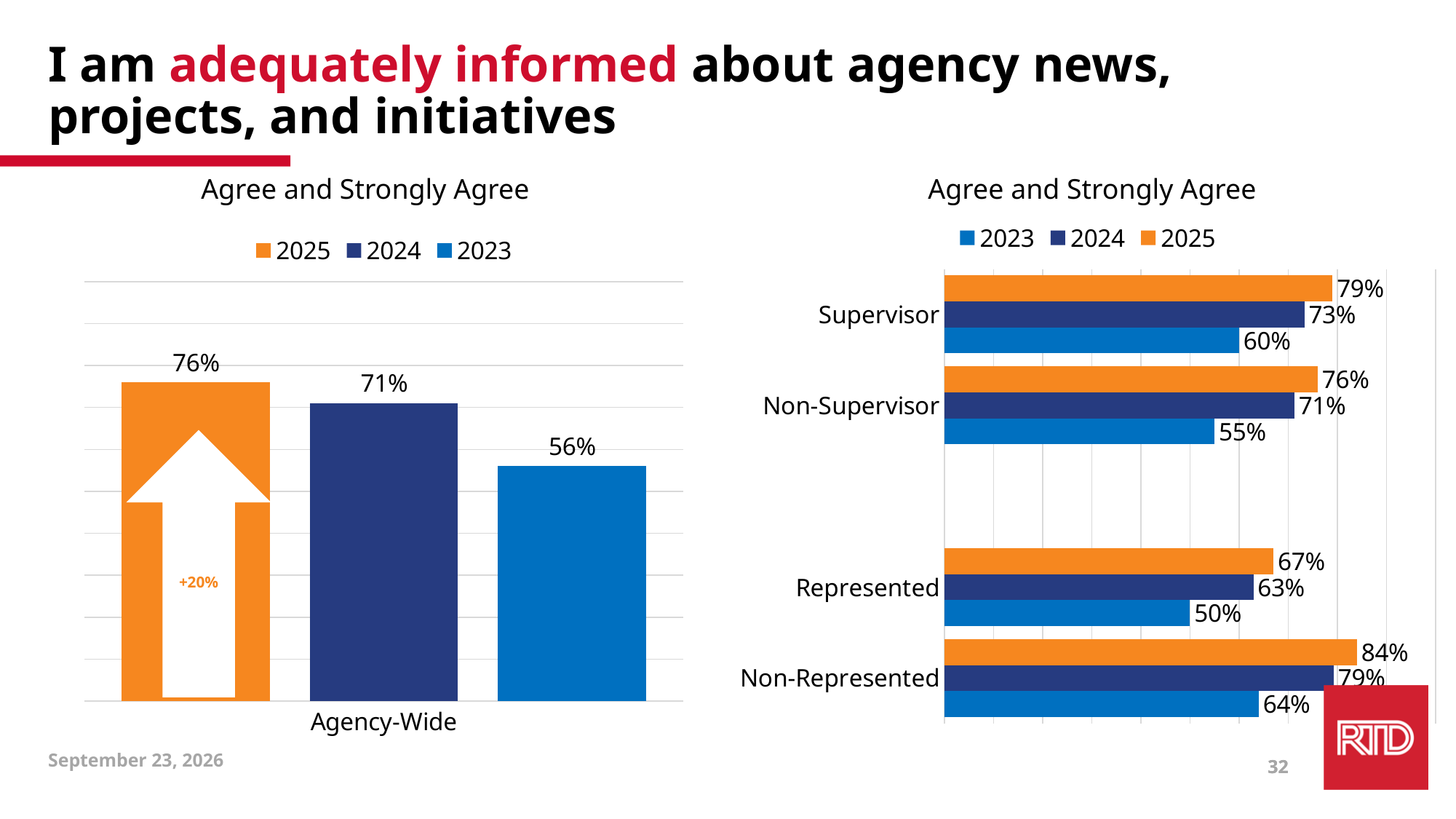
In the left chart (Agency-Wide), what is the difference between the 2025 and 2023 values? 20% In the right chart, what is the 2025 value for Supervisor? 79% In the right chart, which category has the lowest 2023 value? Represented In the left chart (Agency-Wide), how many series does the legend list? 3 In the right chart, which category has the highest 2025 value? Non-Represented In the right chart, what is the 2023 value for Represented? 50% In the left chart (Agency-Wide), what kind of chart is shown? Bar chart In the right chart, what is the difference between the 2025 and 2024 values for Non-Supervisor? 5% In the left chart (Agency-Wide), what is the value for 2023? 56% In the right chart, which is larger: the 2024 value for Supervisor or the 2024 value for Represented? Supervisor In the left chart (Agency-Wide), what is the value for 2025? 76% In the right chart, how many categories are shown? 4